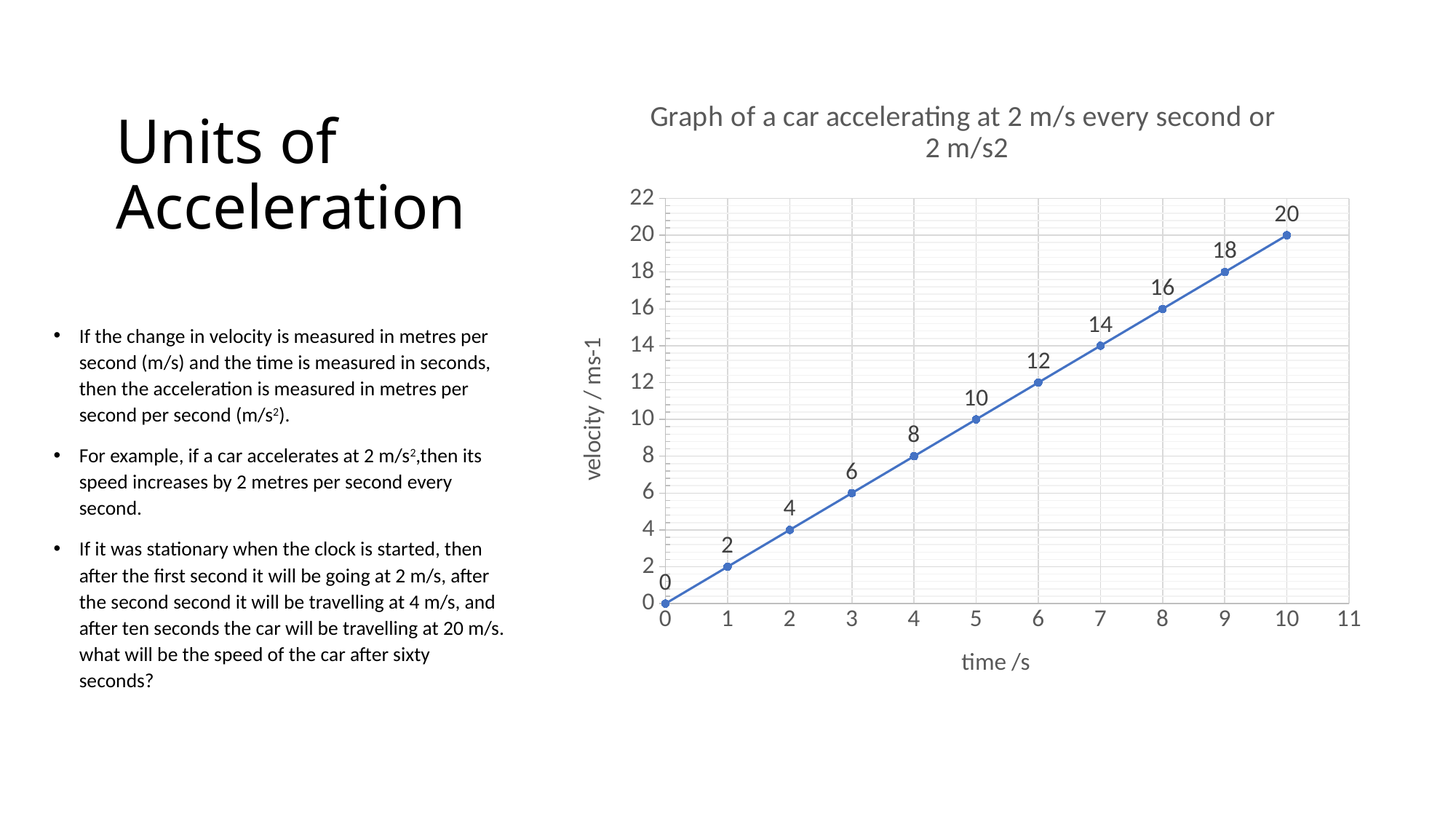
Does the velocity rise or fall as time increases? rise What is the velocity at time 5 s? 10 What kind of chart is shown on the slide? line chart Which is larger, the velocity at 3 s or the velocity at 7 s? 7 s What is the difference between the velocity at 10 s and the velocity at 4 s? 12 What is the title of the chart? Graph of a car accelerating at 2 m/s every second or 2 m/s2 What is the velocity at time 1 s? 2 At which time is the velocity lowest? 0 What is the label of the x axis? time /s How many data points are plotted on the chart? 11 What is the velocity at time 8 s? 16 At which time is the velocity highest? 10